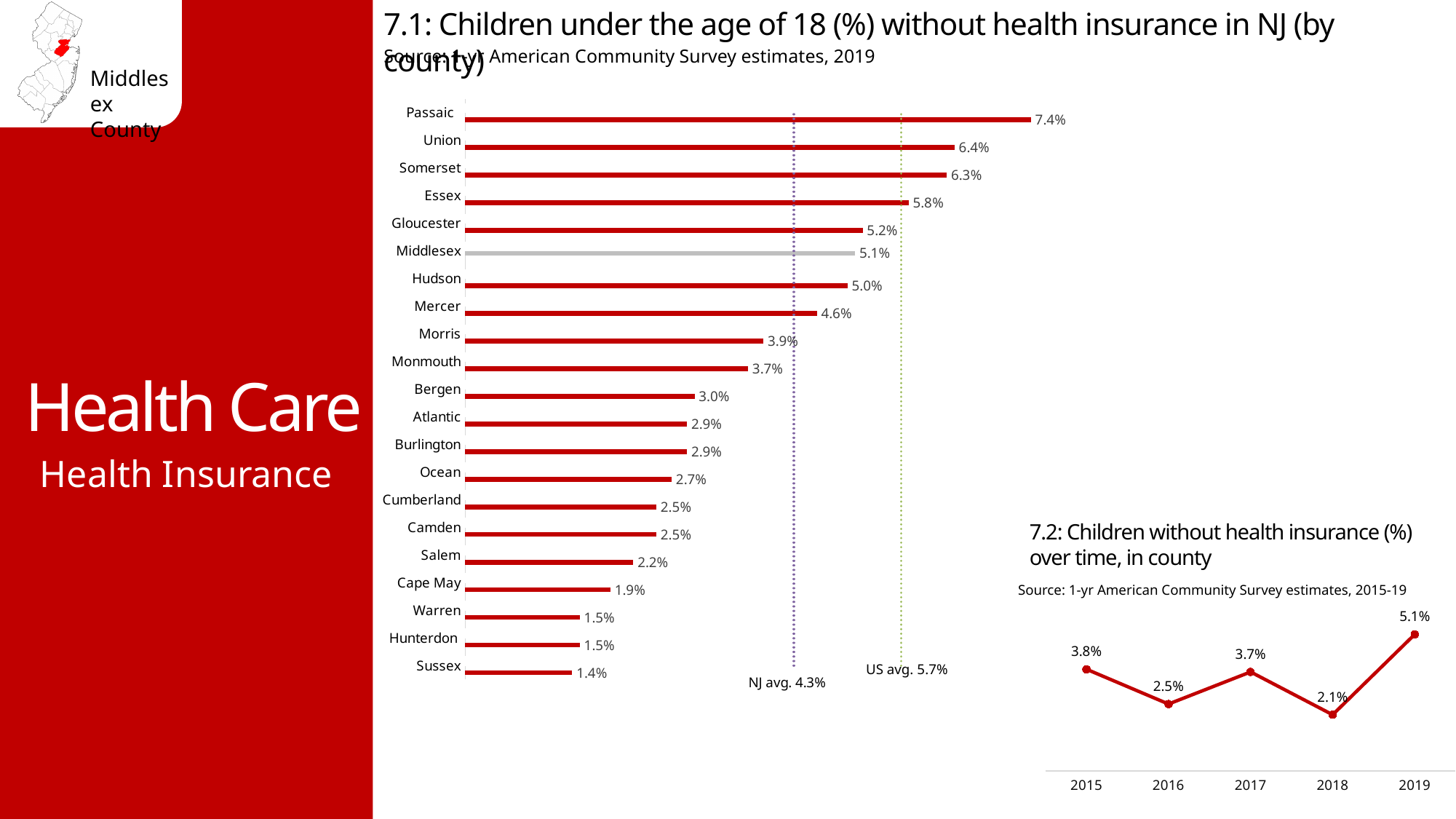
What kind of chart is chart 7.1? Bar chart In chart 7.1, which is larger, the value for Essex or the value for Hudson? Essex In chart 7.1, what is the NJ average shown by the dotted line? 4.3% In chart 7.2, what is the difference between the values for 2019 and 2018? 3.0% In chart 7.1, which county has the lowest percentage of children without health insurance? Sussex In chart 7.2, what is the value for 2019? 5.1% In chart 7.1, which county has the highest percentage of children without health insurance? Passaic In chart 7.1, how many counties are plotted? 21 In chart 7.2, which year has the lowest value? 2018 In chart 7.1, what is the difference between the values for Passaic and Union? 1.0% What kind of chart is chart 7.2? Line chart In chart 7.1, what is the value for Middlesex? 5.1%